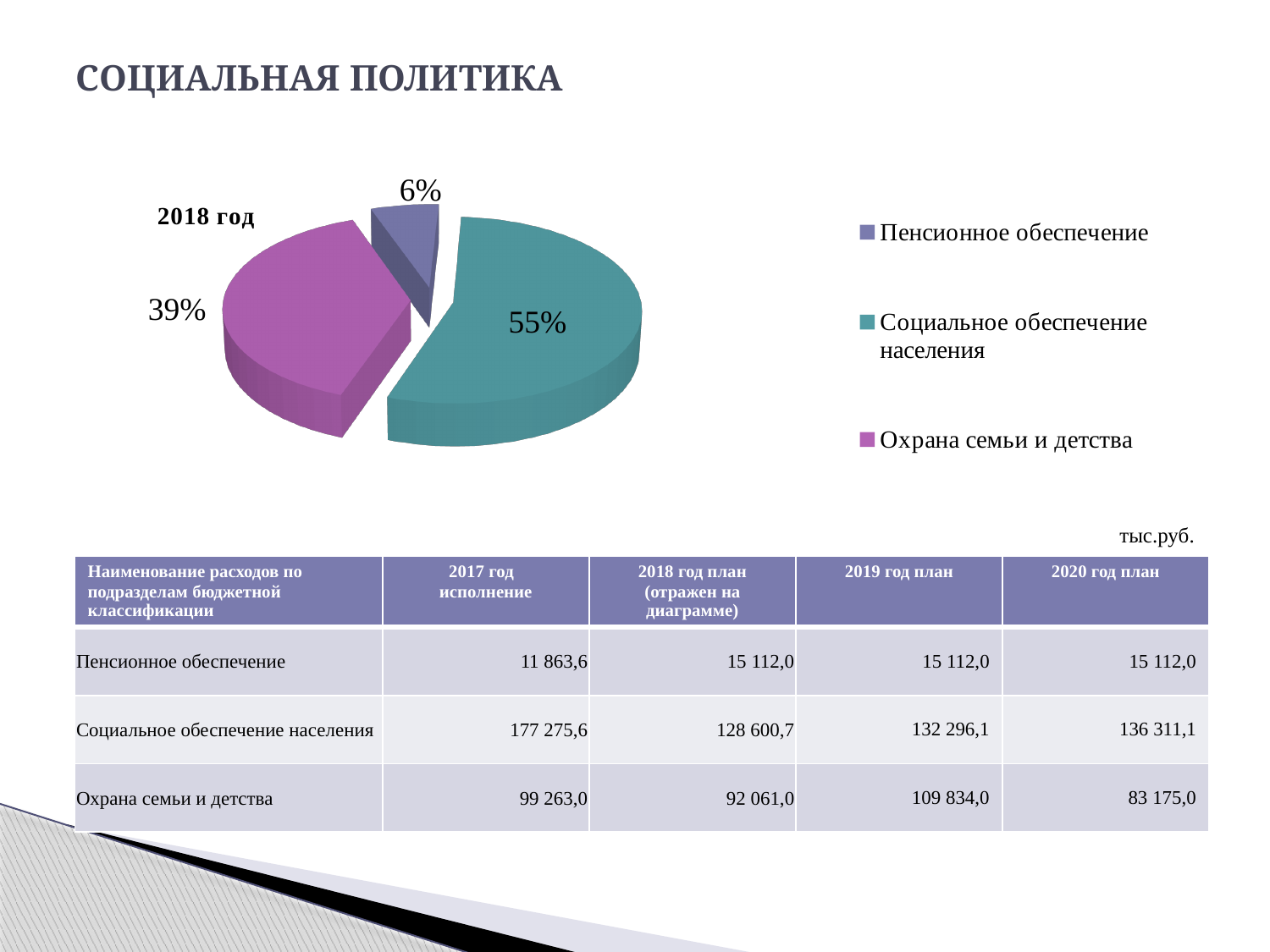
What share of the pie does Социальное обеспечение населения have? 55% How many entries does the legend list? 3 Which category has the smallest slice of the pie? Пенсионное обеспечение Which year does the pie chart represent, according to its label? 2018 год What colour is the slice for Социальное обеспечение населения? teal How many slices does the pie chart have? 3 Which category has the largest slice of the pie? Социальное обеспечение населения What kind of chart is shown on the slide? pie chart Which is larger: the slice for Охрана семьи и детства or the slice for Пенсионное обеспечение? Охрана семьи и детства What share of the pie does Пенсионное обеспечение have? 6% What share of the pie does Охрана семьи и детства have? 39% What is the difference in percentage points between the Социальное обеспечение населения slice and the Охрана семьи и детства slice? 16